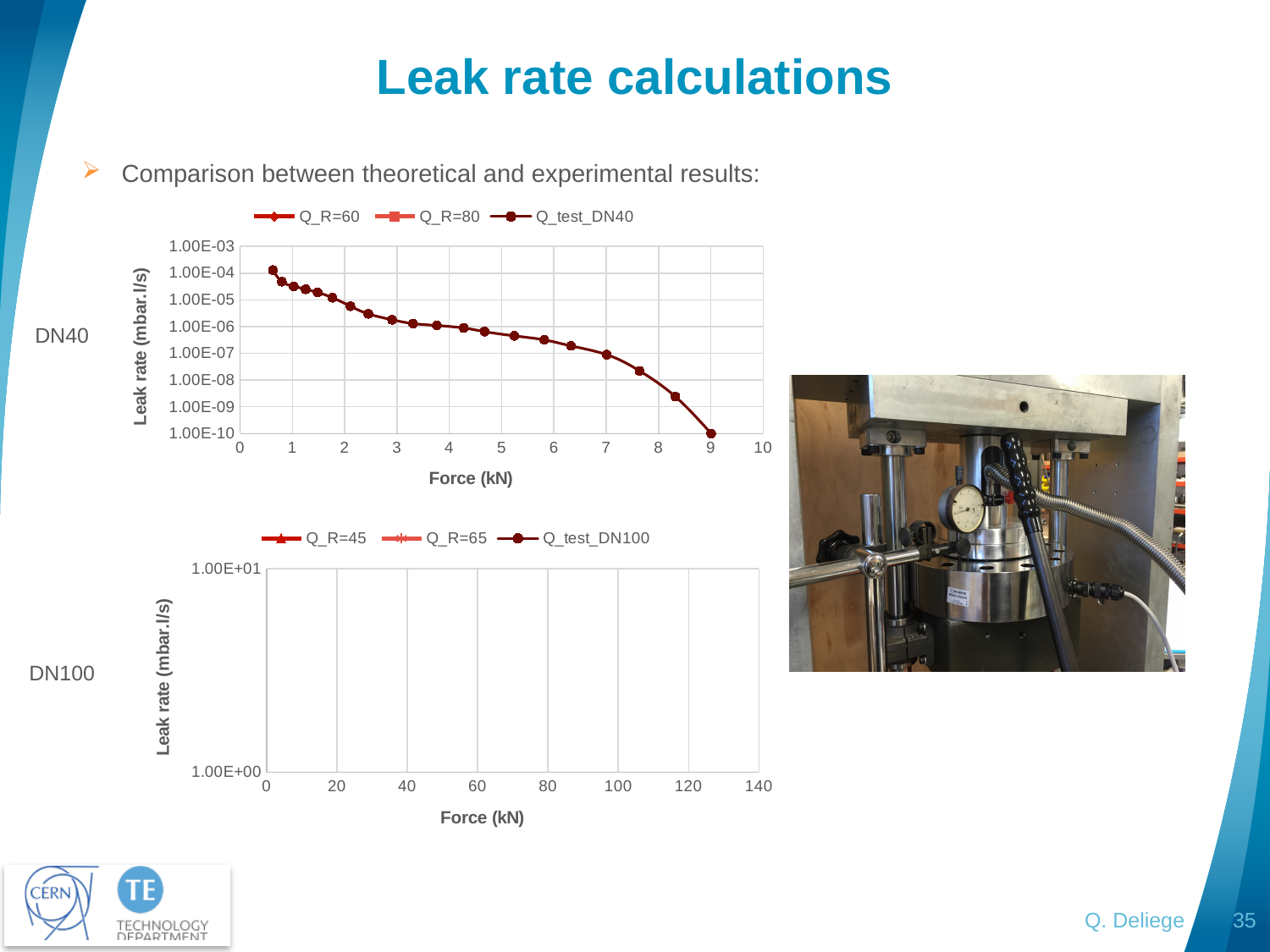
What is the highest value shown on the x axis of the DN40 chart? 10 In the DN40 chart, does the leak rate rise or fall as the force increases along the x axis? fall What is the lowest value shown on the y axis of the DN40 chart? 1.00E-10 What is the label of the y axis of the DN100 chart? Leak rate (mbar.l/s) What is the label of the x axis of the DN40 chart? Force (kN) What is the highest value shown on the x axis of the DN100 chart? 140 How many series does the legend of the DN100 chart list? 3 In the DN40 chart, is the leak rate at a force of 7 kN greater or less than 1.00E-06 mbar.l/s? less In the DN40 chart, is the leak rate at a force of 8 kN greater or less than 1.00E-07 mbar.l/s? less How many series does the legend of the DN40 chart list? 3 What kind of chart is the DN40 chart at the top of the slide? line chart In the DN40 chart, is the leak rate at a force of 1 kN greater or less than 1.00E-05 mbar.l/s? greater